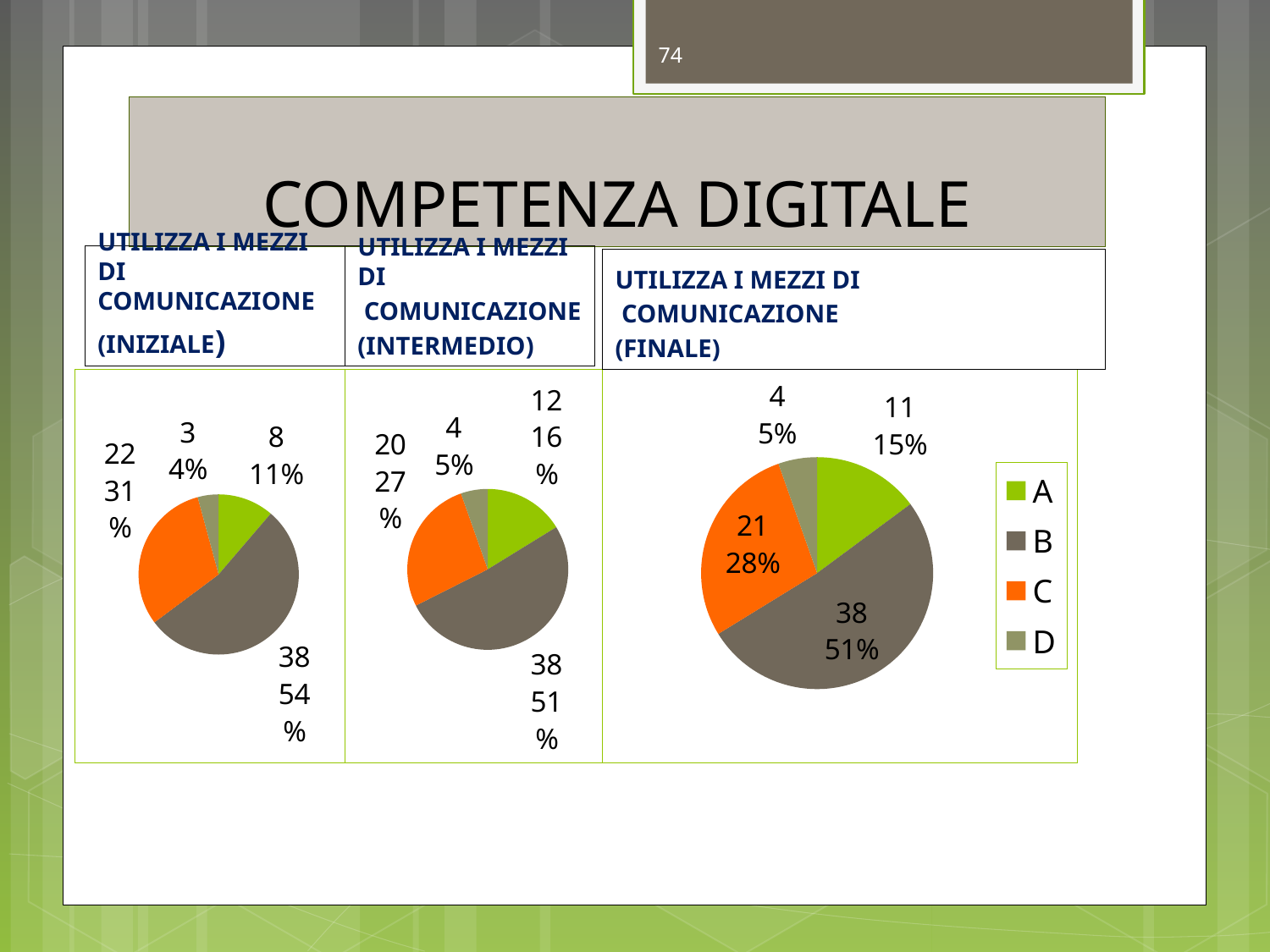
In the (FINALE) pie chart, what share of the pie does category A represent? 15% In the (FINALE) pie chart, what share of the pie does category C represent? 28% In the (INIZIALE) pie chart, what is the value for the orange slice (C)? 22 In the (FINALE) pie chart, which is larger, the value for A or the value for C? C In the (INIZIALE) pie chart, what is the difference between the values for B and C? 16 In the (INTERMEDIO) pie chart, which category has the smallest slice? D In the (FINALE) pie chart, what is the value for category B? 38 How many categories does the legend on the (FINALE) chart list? 4 What kind of chart is used in the UTILIZZA I MEZZI DI COMUNICAZIONE (FINALE) panel? Pie chart In the (FINALE) pie chart, which category has the largest slice? B In the (INTERMEDIO) pie chart, what is the value for the green slice (A)? 12 In the (INIZIALE) pie chart, what share of the pie does the largest slice (B) represent? 54%